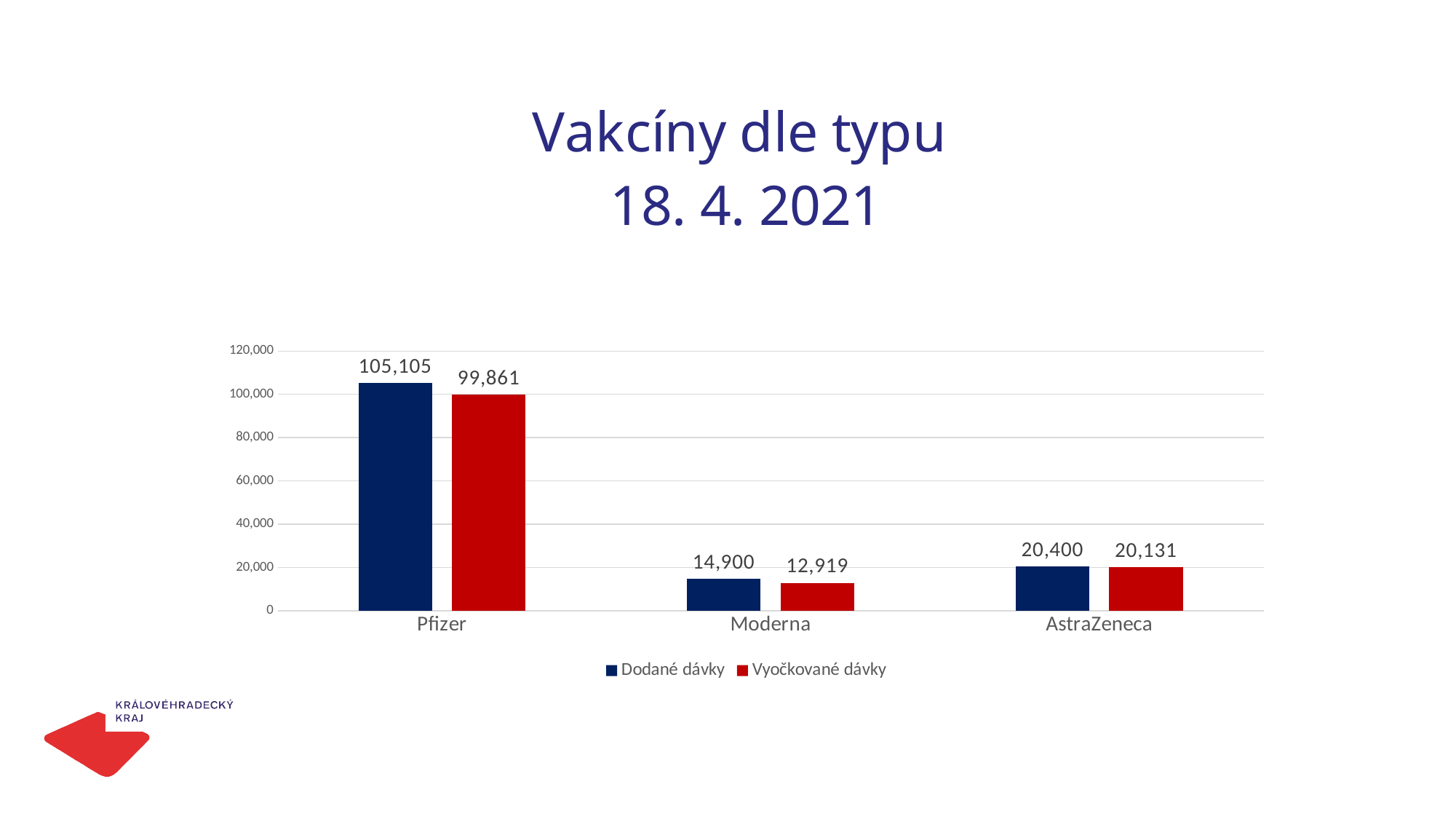
What is the value of Dodané dávky for AstraZeneca? 20,400 What is the difference between Dodané dávky and Vyočkované dávky for Pfizer? 5,244 What is the value of Dodané dávky for Pfizer? 105,105 How many vaccine types are shown on the x axis? 3 What kind of chart is shown on the slide? Bar chart What is the title of the slide? Vakcíny dle typu 18. 4. 2021 What is the difference between Dodané dávky and Vyočkované dávky for AstraZeneca? 269 Which vaccine type has the lowest Vyočkované dávky value? Moderna How many series does the legend list? 2 What is the value of Vyočkované dávky for Moderna? 12,919 Which is larger: Dodané dávky for Moderna or Dodané dávky for AstraZeneca? AstraZeneca Which vaccine type has the highest Dodané dávky value? Pfizer